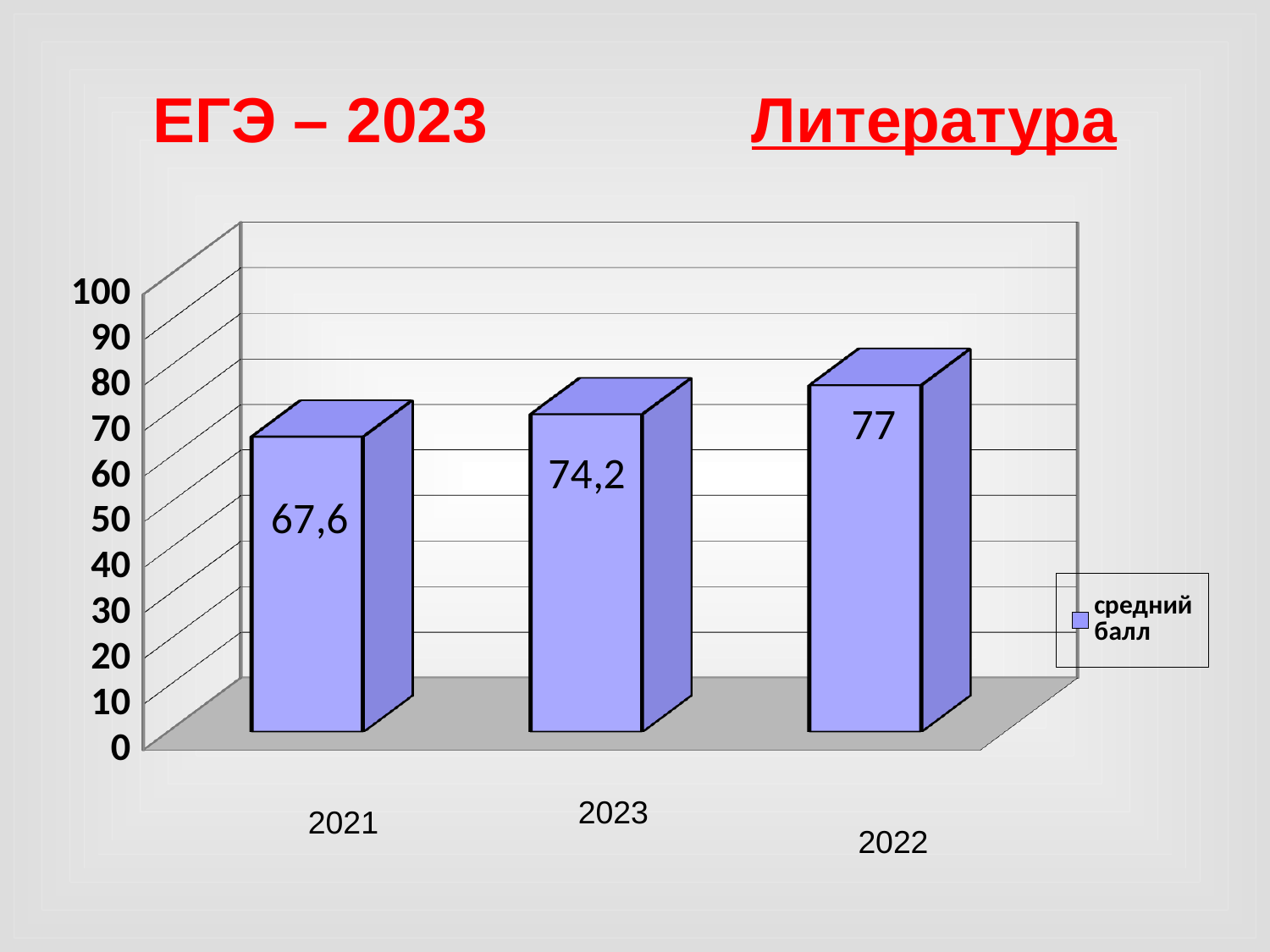
How many years (categories) are shown on the chart? 3 How many series does the legend list? 1 Which year has the highest average score? 2022 What is the difference between the average score for 2022 and for 2021? 9,4 What is the average score shown for 2023? 74,2 Which is larger, the average score for 2023 or for 2022? 2022 What is the average score (средний балл) shown for 2021? 67,6 What kind of chart is shown on the slide? Bar chart What is the difference between the average score for 2023 and for 2021? 6,6 What is the legend entry on the chart? средний балл What is the average score shown for 2022? 77 Which year has the lowest average score? 2021